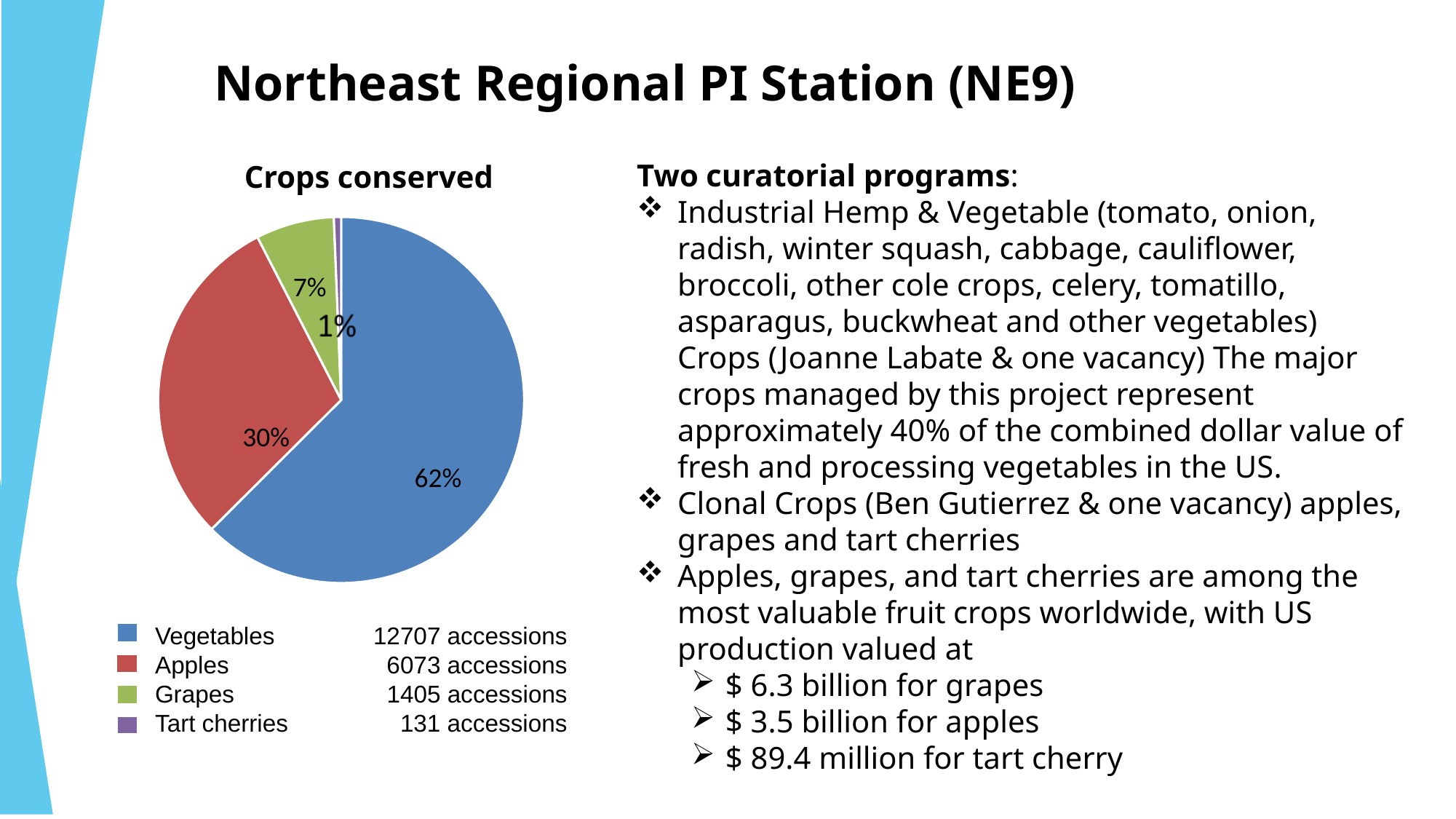
What is the difference in percentage points between the Vegetables and Apples slices? 32% How many crop categories are shown in the "Crops conserved" pie chart? 4 Which crop has the largest slice in the "Crops conserved" pie chart? Vegetables What share of the "Crops conserved" pie is Apples? 30% How many accessions does the legend list for Grapes? 1405 accessions What share of the "Crops conserved" pie is Grapes? 7% Which colour represents Apples in the "Crops conserved" pie chart? red What share of the "Crops conserved" pie is Tart cherries? 1% What kind of chart is shown under the title "Crops conserved"? pie chart How many accessions does the legend list for Apples? 6073 accessions Which crop has the smallest slice in the "Crops conserved" pie chart? Tart cherries